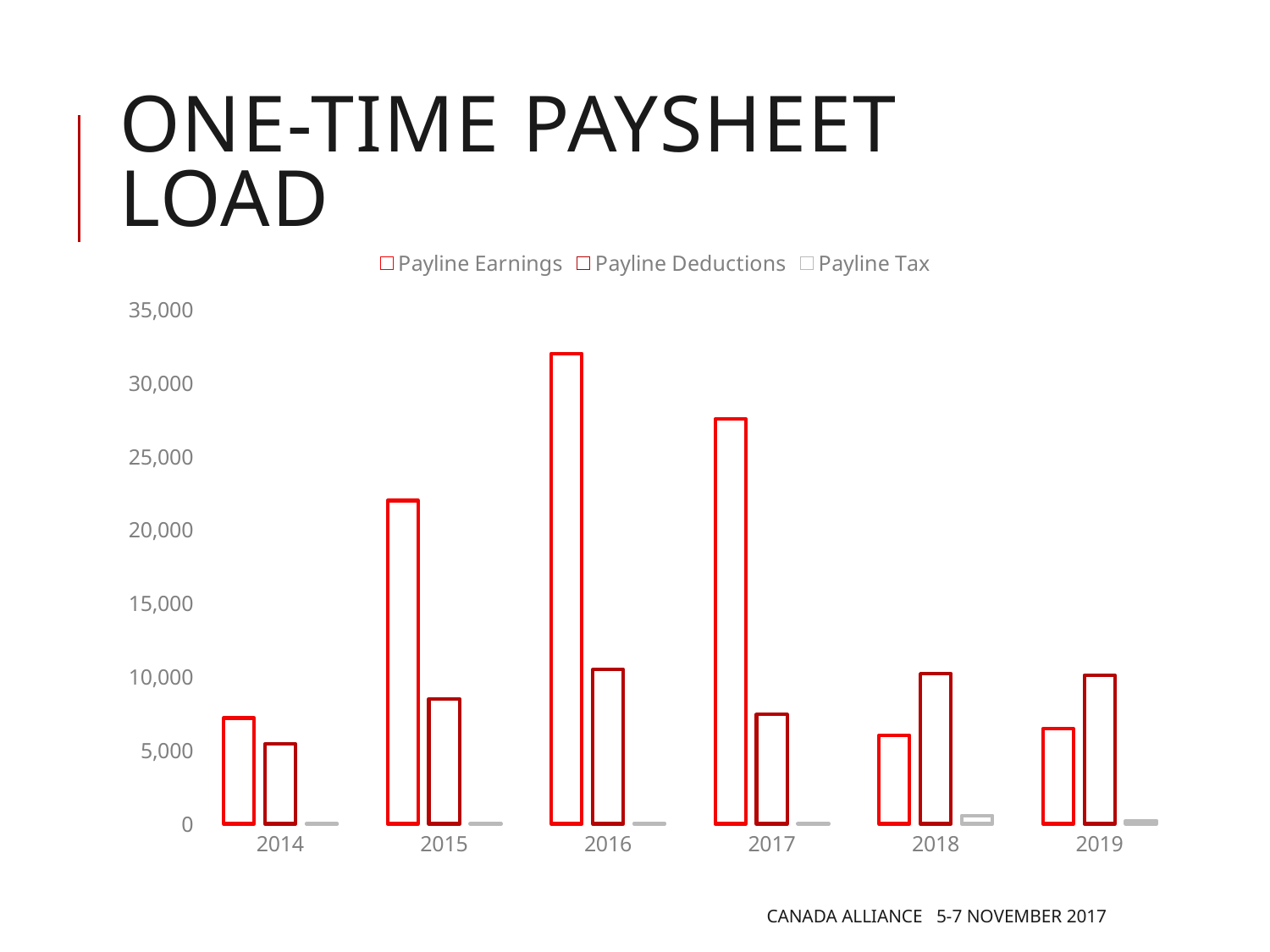
What kind of chart is shown on the slide? bar chart Which year has the lowest Payline Deductions? 2014 Which is larger, Payline Earnings in 2015 or Payline Earnings in 2017? Payline Earnings in 2017 Which year has the highest Payline Earnings? 2016 Is the value for Payline Deductions in 2018 greater or less than 5,000? greater Is the value for Payline Earnings in 2015 greater or less than 20,000? greater In 2018, which is larger, Payline Earnings or Payline Deductions? Payline Deductions What are the three series listed in the chart's legend? Payline Earnings, Payline Deductions, Payline Tax Is the value for Payline Earnings in 2016 greater or less than 30,000? greater How many years are shown on the x axis of the chart? 6 How many series does the chart's legend list? 3